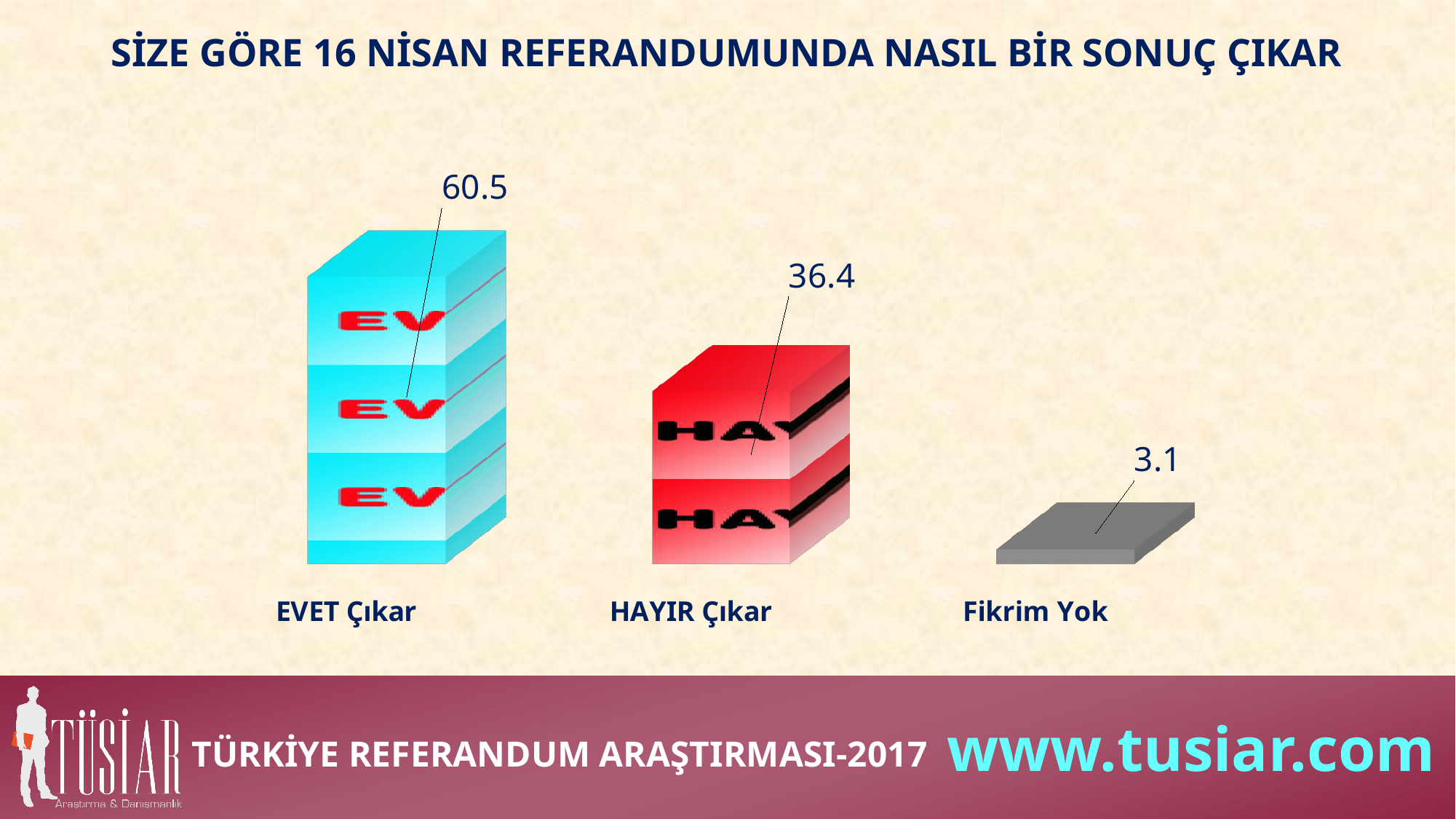
What is the difference between the values for EVET Çıkar and HAYIR Çıkar? 24.1 Which is larger, the value for HAYIR Çıkar or the value for Fikrim Yok? HAYIR Çıkar How many categories are shown in the chart? 3 What is the value for HAYIR Çıkar? 36.4 Do the values rise or fall from left to right across the categories? Fall What is the value for EVET Çıkar? 60.5 What is the difference between the values for HAYIR Çıkar and Fikrim Yok? 33.3 What is the title of the chart? SİZE GÖRE 16 NİSAN REFERANDUMUNDA NASIL BİR SONUÇ ÇIKAR What is the value for Fikrim Yok? 3.1 Which category has the lowest value? Fikrim Yok Which category has the highest value? EVET Çıkar What kind of chart is shown on the slide? Bar chart